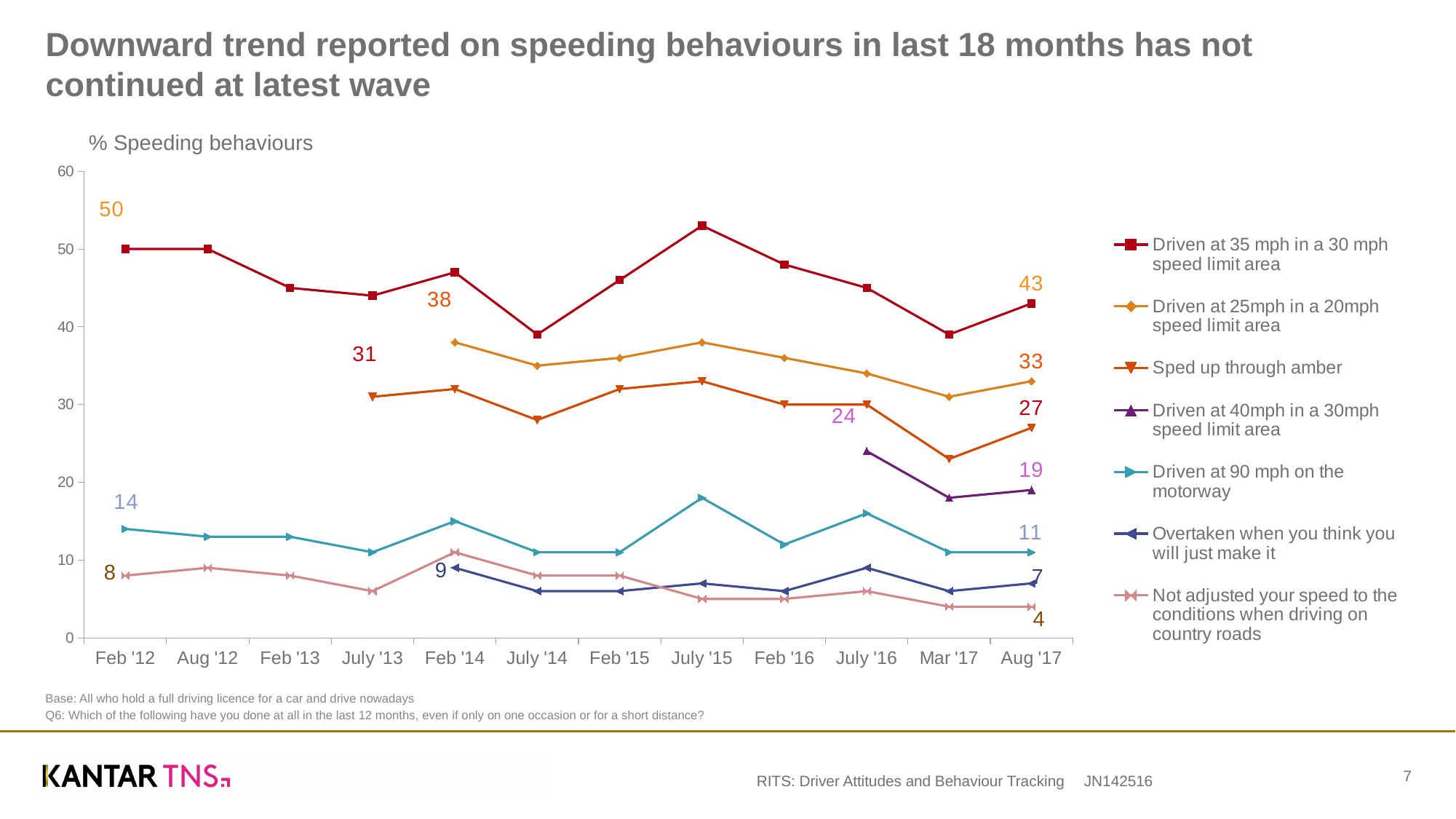
Is the value for 'Driven at 35 mph in a 30 mph speed limit area' at July '15 greater or less than 50? greater Which series has the lowest value at Aug '17? Not adjusted your speed to the conditions when driving on country roads What kind of chart is shown on the slide? Line chart What is the value for 'Driven at 90 mph on the motorway' at Feb '12? 14 What is the value for 'Driven at 35 mph in a 30 mph speed limit area' at Aug '17? 43 By how much did 'Driven at 35 mph in a 30 mph speed limit area' fall from Feb '12 to Aug '17? 7 What is the value for 'Driven at 25mph in a 20mph speed limit area' at Aug '17? 33 How many series does the legend list? 7 At Aug '17, which is larger: 'Driven at 90 mph on the motorway' or 'Overtaken when you think you will just make it'? Driven at 90 mph on the motorway What is the value for 'Sped up through amber' at July '13? 31 How many time points are shown along the x axis? 12 What is the value for 'Driven at 40mph in a 30mph speed limit area' at Aug '17? 19